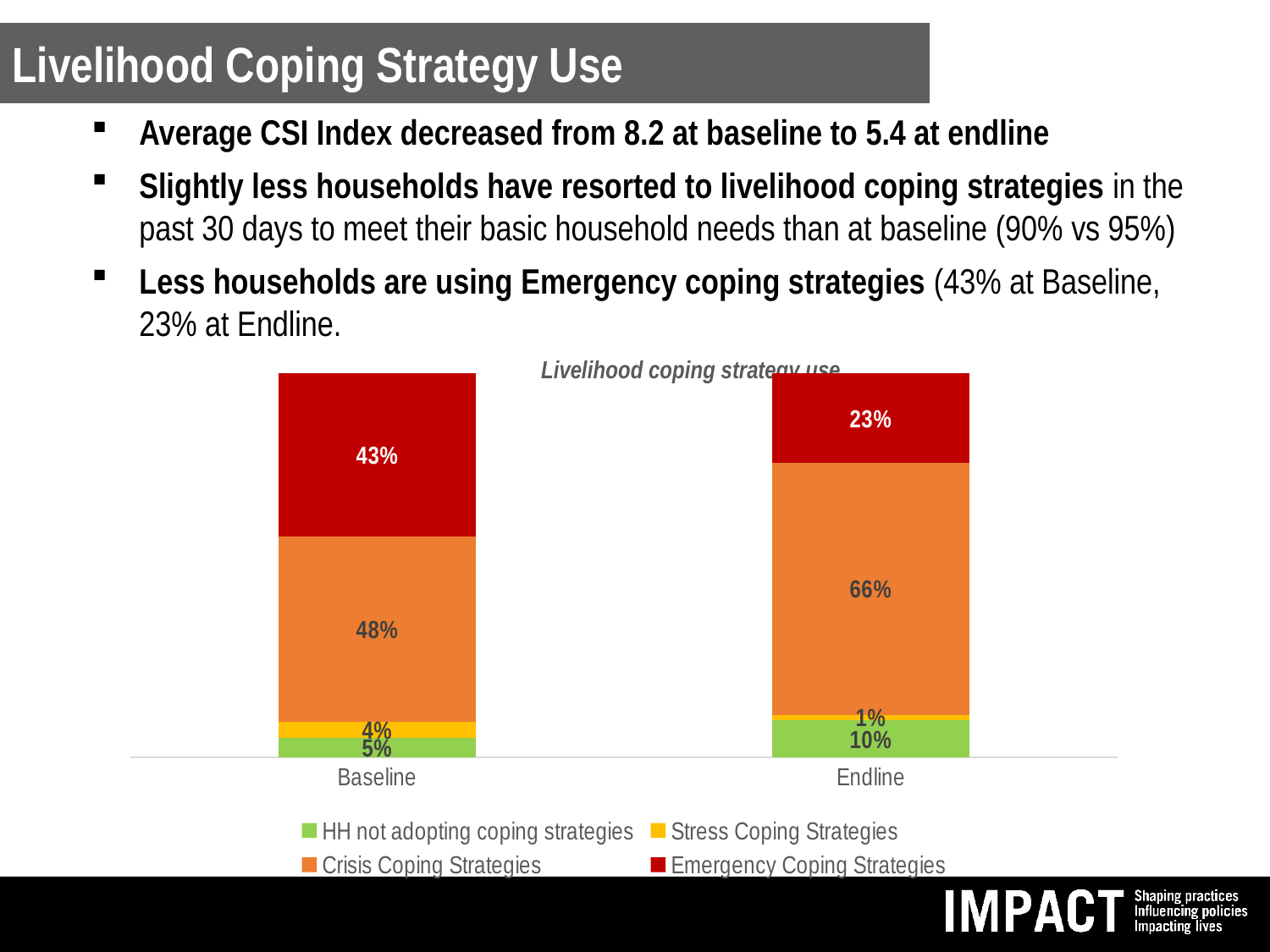
What is the value for Stress Coping Strategies at Baseline? 4% What is the title of the chart? Livelihood coping strategy use What kind of chart is shown on the slide? Stacked bar chart How many series does the legend list? 4 What is the value for Crisis Coping Strategies at Endline? 66% Which series has the smallest value in the Endline bar? Stress Coping Strategies Is the Crisis Coping Strategies value larger at Baseline or at Endline? Endline What is the difference between the Emergency Coping Strategies values at Baseline and Endline? 20% Which series has the largest value in the Endline bar? Crisis Coping Strategies What is the value for Emergency Coping Strategies at Baseline? 43% How many categories are shown on the x axis? 2 What is the value for HH not adopting coping strategies at Endline? 10%